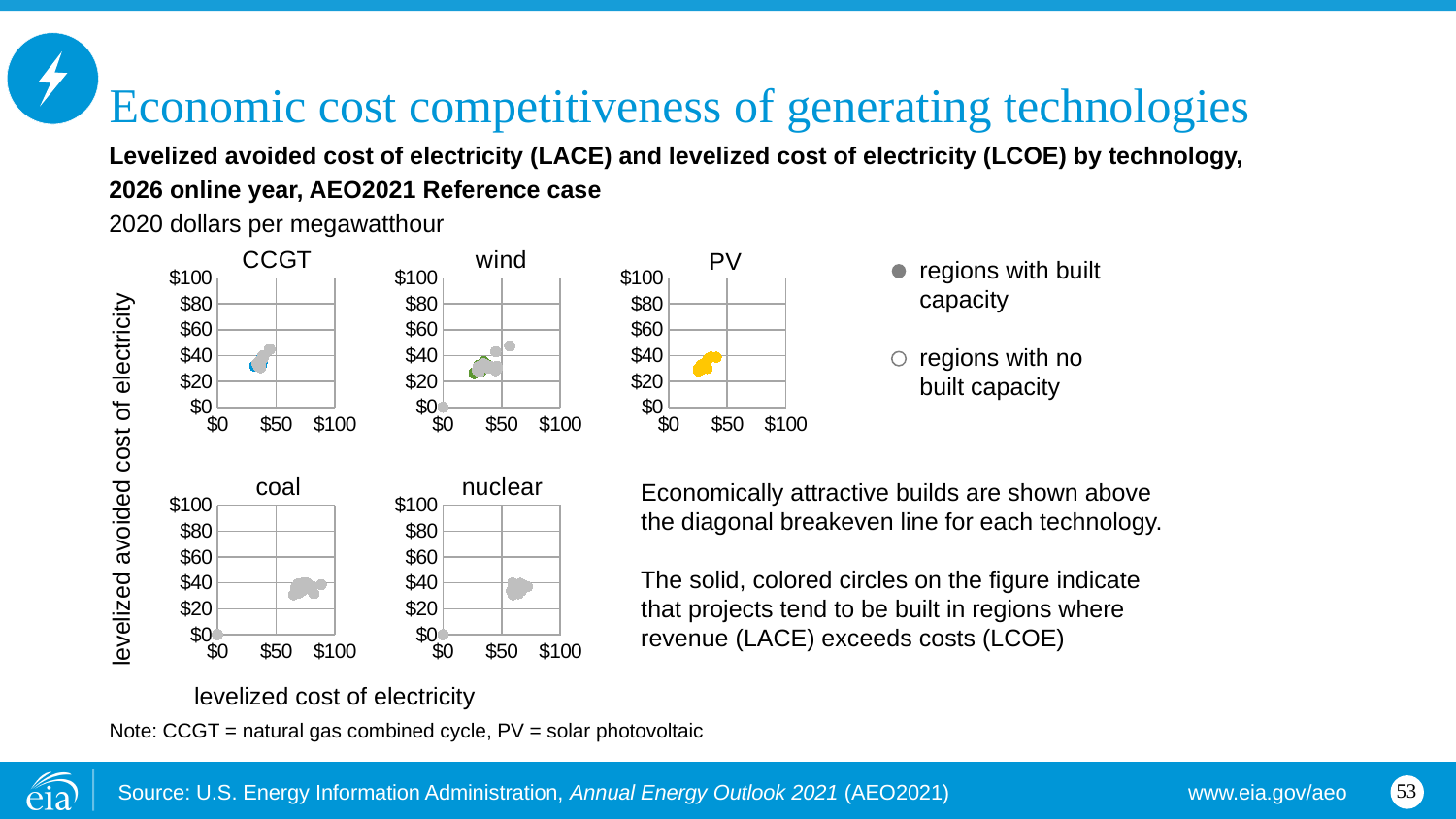
In the wind chart, are the plotted points' levelized avoided cost values greater or less than $80? less In the PV chart, are the plotted points' levelized avoided cost values greater or less than $60? less What is the maximum value shown on the vertical axis of each chart? $100 What does a solid circle represent according to the legend? regions with built capacity In the nuclear chart, are the plotted points' levelized avoided cost values greater or less than $80? less What kind of chart is used for the CCGT panel? scatter chart How many technology panels (charts) are shown on the slide? 5 What is the label of the vertical axis shared by the charts? levelized avoided cost of electricity How many entries does the legend list? 2